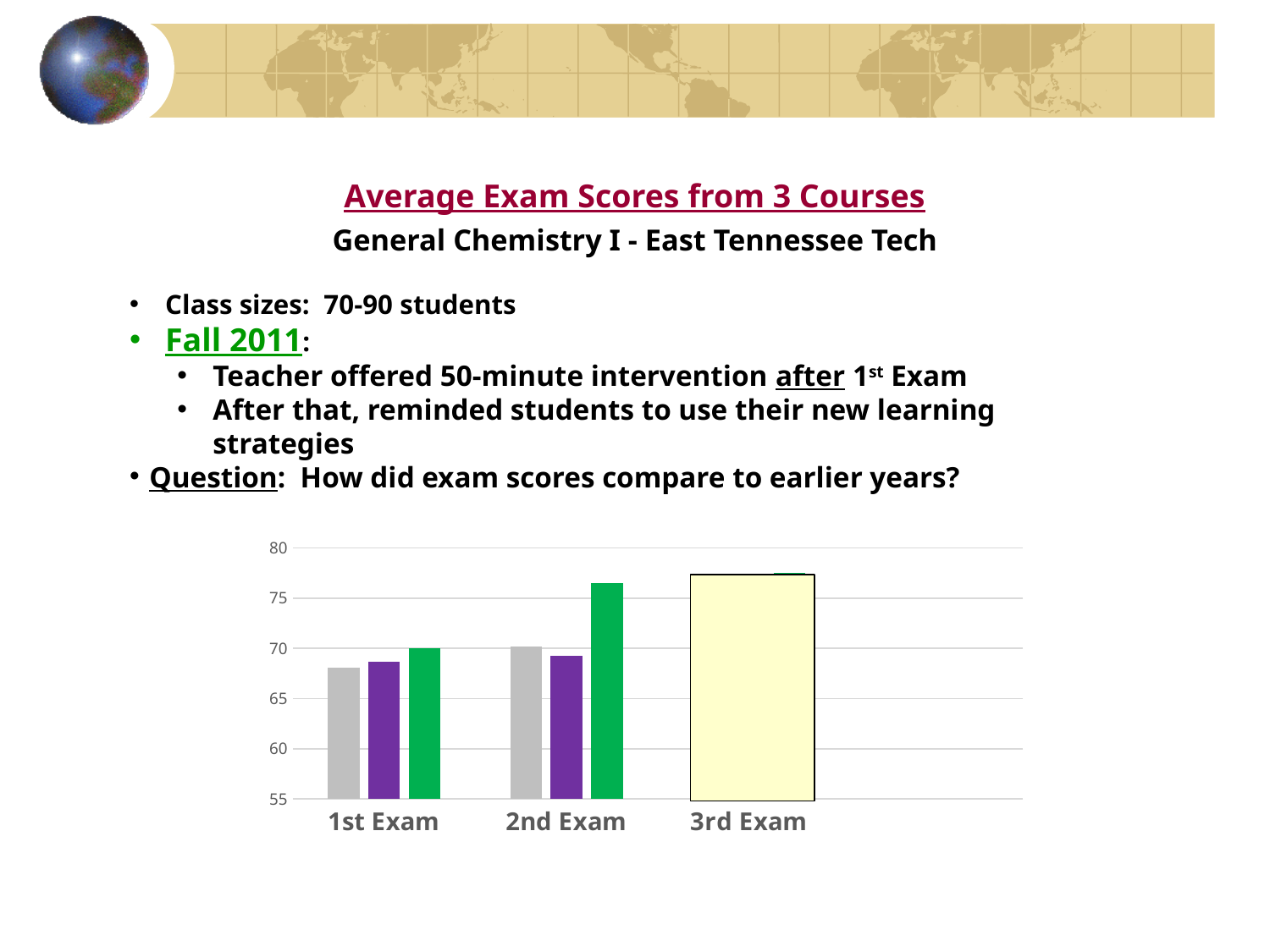
What is the lowest value shown on the chart's vertical axis? 55 Which bar is the tallest in the 1st Exam category? the green bar Is the value of the purple bar for the 2nd Exam greater or less than 70? less Do the green bars rise or fall from the 1st Exam to the 2nd Exam? rise Which is larger: the green bar for the 1st Exam or the green bar for the 2nd Exam? the green bar for the 2nd Exam What kind of chart is shown on the slide? bar chart Is the value of the gray bar for the 1st Exam greater or less than 70? less How many bars are shown for the 1st Exam category? 3 Is the value of the green bar for the 1st Exam greater or less than 65? greater Which bar is the tallest in the 2nd Exam category? the green bar How many exam categories are labeled on the x axis of the chart? 3